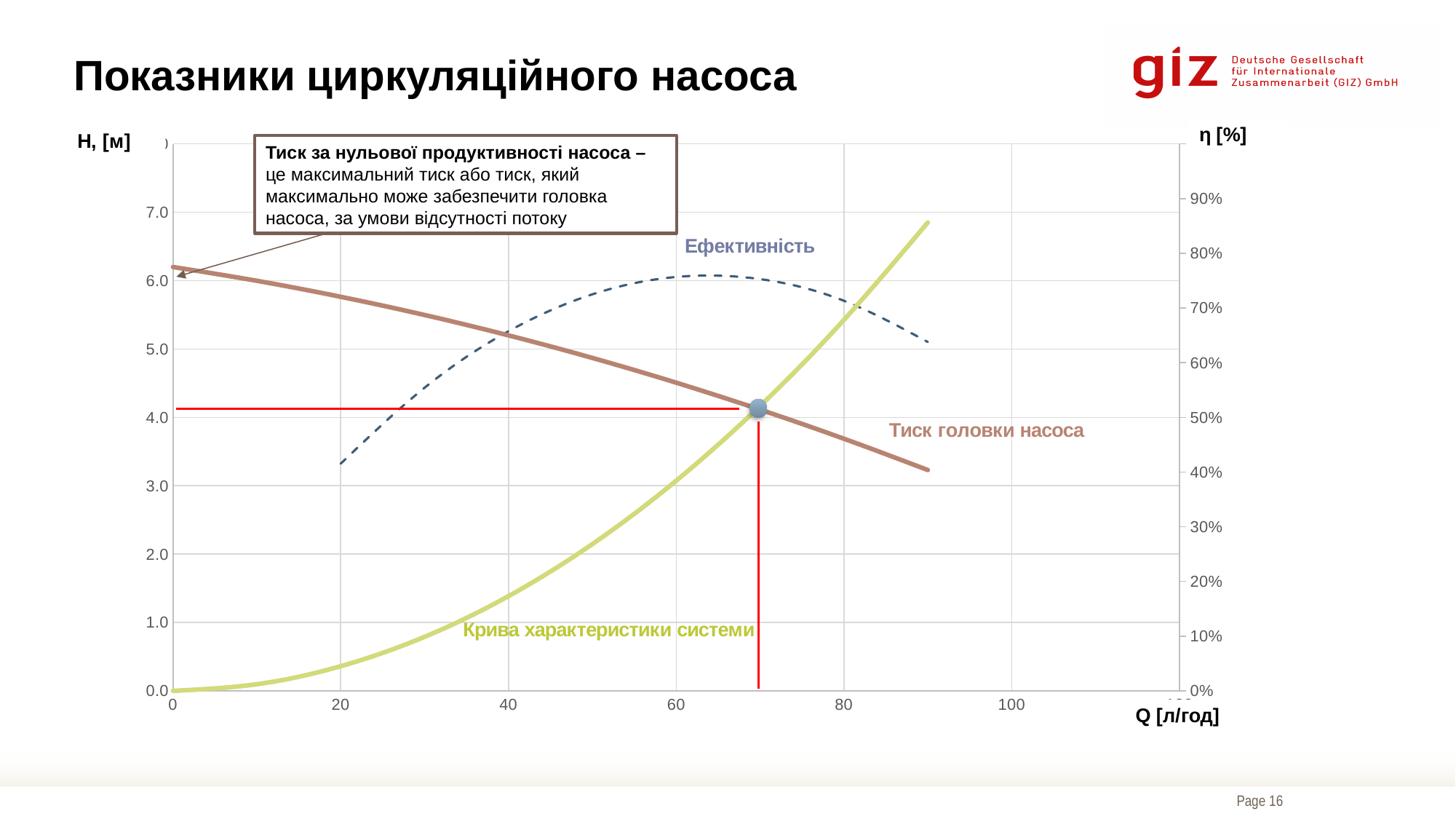
Is the value of the "Тиск головки насоса" curve at Q = 90 greater or less than 4.0? less Is the value of the "Крива характеристики системи" curve at Q = 40 greater or less than 2.0? less Is the peak of the "Ефективність" curve greater or less than 70%? greater What kind of chart is shown on the slide? line chart How many curves are plotted on the chart? 3 Does the curve labelled "Тиск головки насоса" rise or fall as Q increases? falls At Q = 20, which curve has the higher value on the H axis: "Тиск головки насоса" or "Крива характеристики системи"? Тиск головки насоса What is the title of the slide containing the chart? Показники циркуляційного насоса What is the label of the left vertical axis of the chart? H, [м] Does the curve labelled "Крива характеристики системи" rise or fall as Q increases? rises